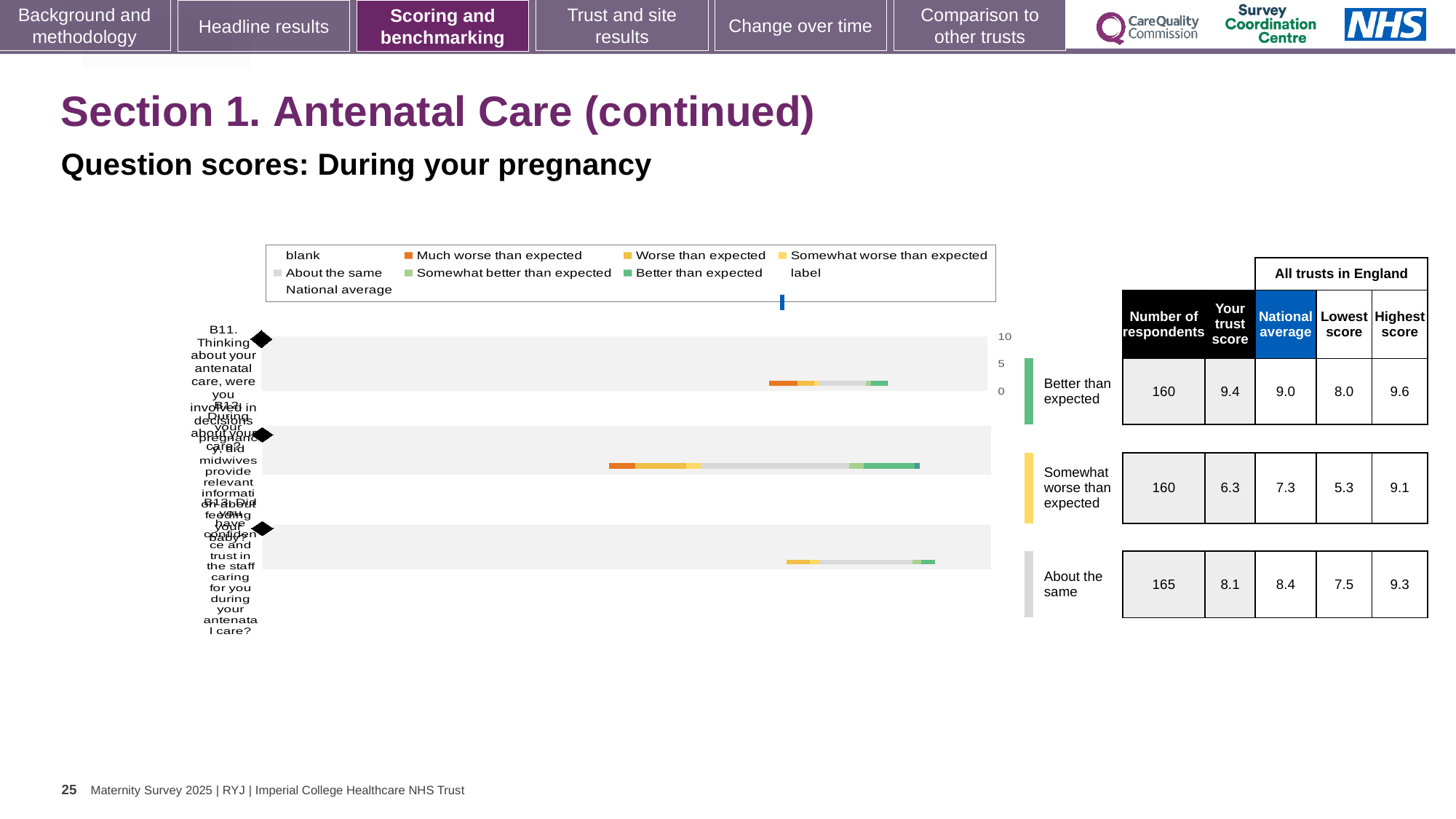
For question B11, is the trust score higher or lower than the national average? higher Which question has the highest trust score in the table beside the chart? B11 In the chart legend, what colour represents 'Much worse than expected'? orange What benchmark category is given for question B12? Somewhat worse than expected How many questions (categories) are plotted in the chart? 3 How many respondents are listed for question B13 in the table beside the chart? 165 In the chart legend, what colour represents 'Better than expected'? green Which question has the lowest trust score in the table beside the chart? B12 What is the trust score for question B11 shown in the table beside the chart? 9.4 For question B12, what is the difference between the national average and the trust score? 1.0 What is the national average for question B12 shown in the table beside the chart? 7.3 What kind of chart is shown on the slide? bar chart